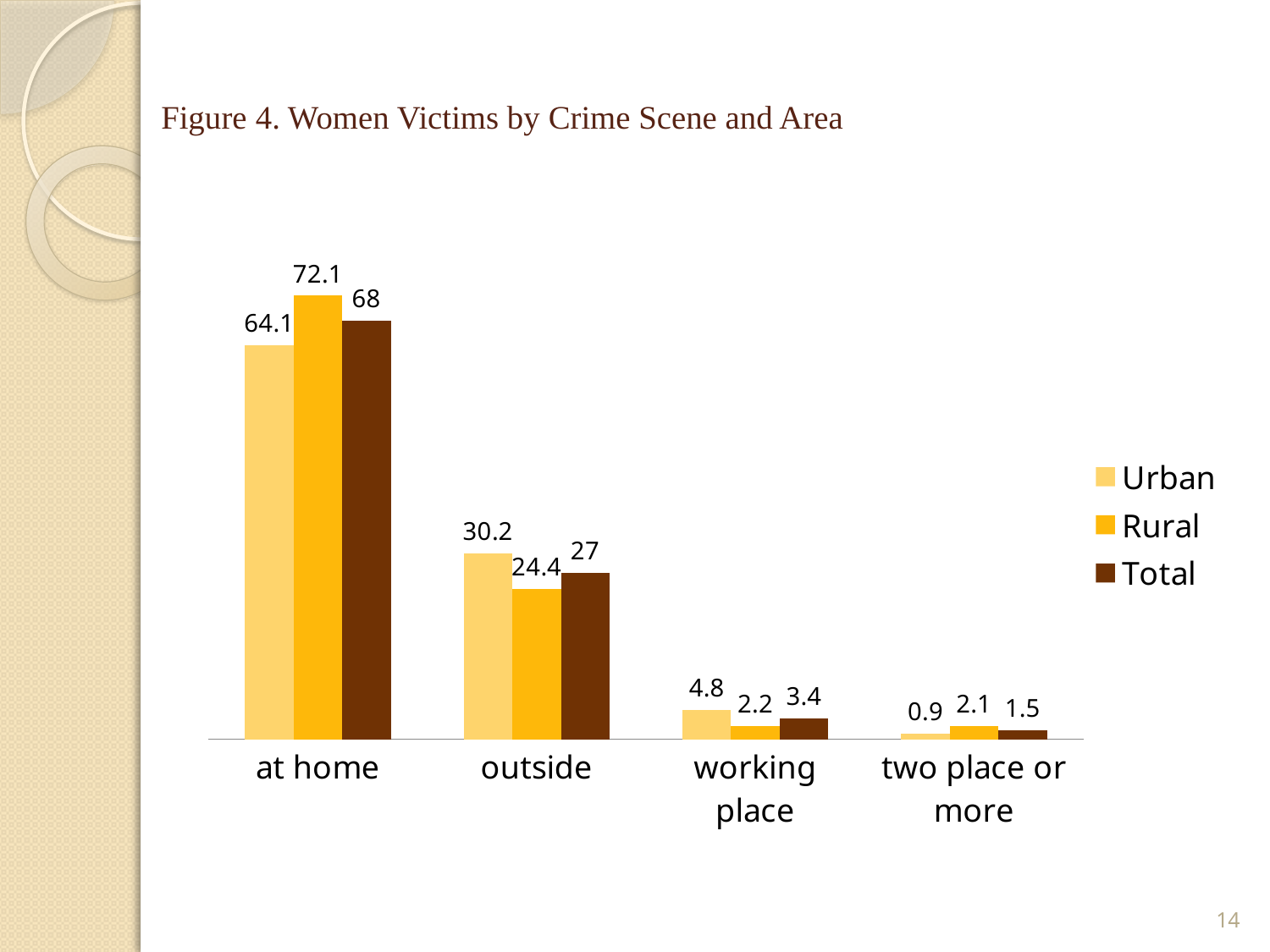
How many crime scene categories are shown on the x axis? 4 Which crime scene has the lowest Rural value? two place or more What kind of chart is shown on the slide? bar chart How many series does the legend list? 3 What is the Rural value for 'at home'? 72.1 What is the Urban value for 'two place or more'? 0.9 What is the difference between the Rural and Urban values for 'at home'? 8 What is the Urban value for 'outside'? 30.2 Which crime scene has the highest Total value? at home What is the Total value for 'working place'? 3.4 What is the difference between the Urban and Rural values for 'outside'? 5.8 For 'working place', which is larger, the Urban value or the Rural value? Urban